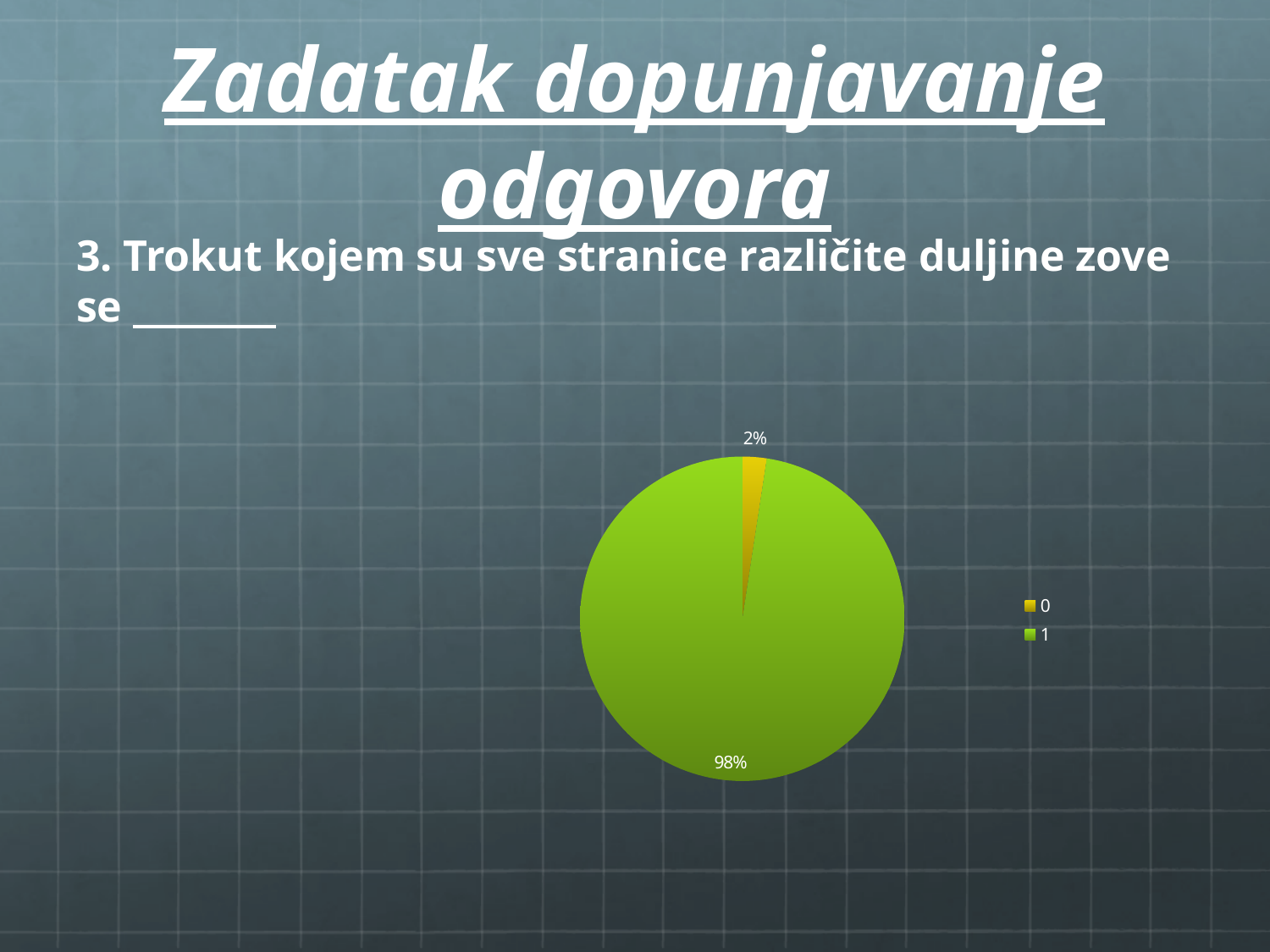
Which category has the largest slice of the pie? 1 Which category has the smallest slice of the pie? 0 Which slice is larger, the one for 0 or the one for 1? 1 What colour is the slice for category 1? green What share of the pie does category 1 have? 98% What colour is the slice for category 0? yellow How many entries does the legend list? 2 What share of the pie does category 0 have? 2% What kind of chart is shown on the slide? pie chart What is the difference in percentage points between the slice for 1 and the slice for 0? 96 How many slices does the pie chart have? 2